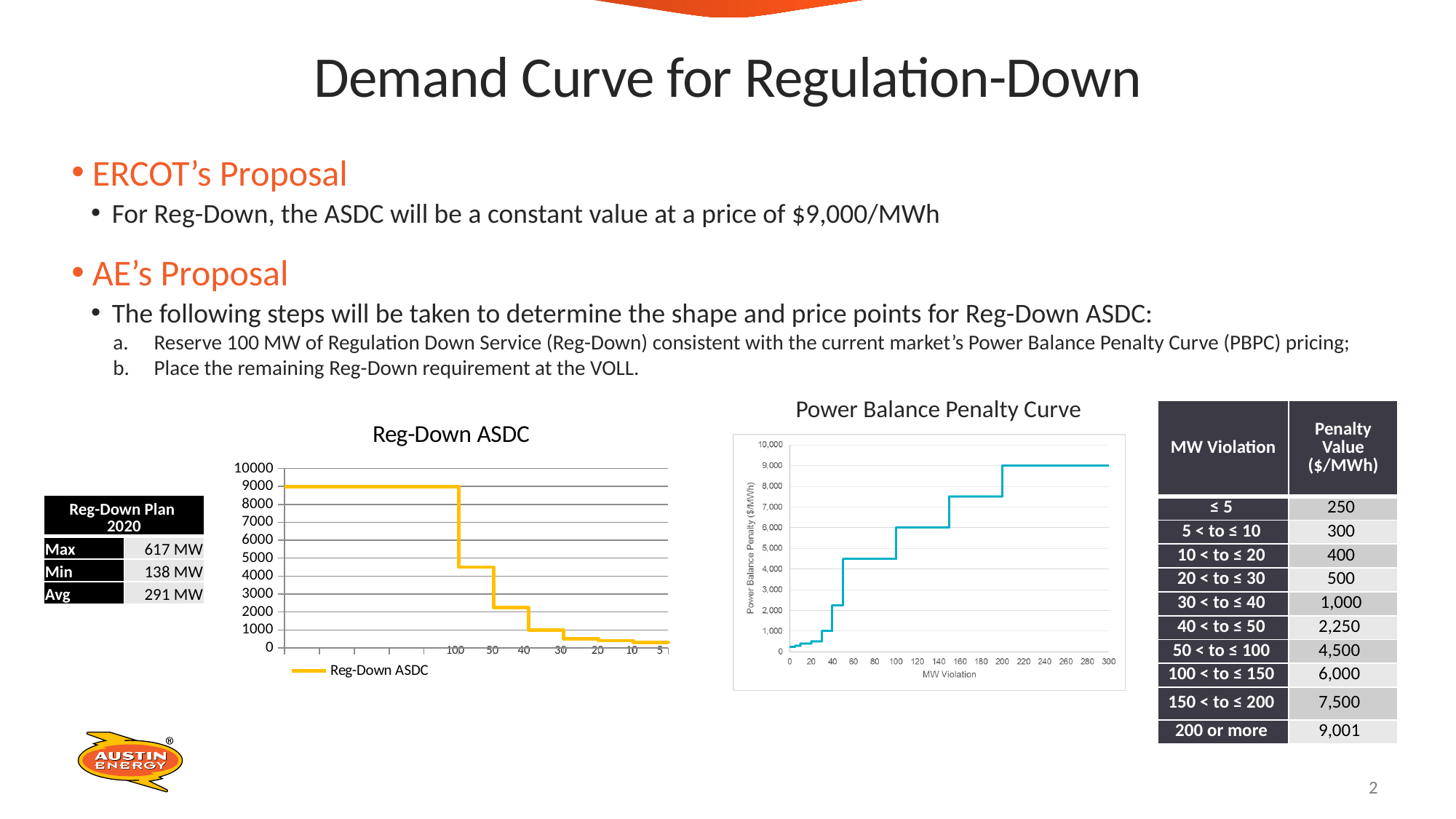
How many series does the legend of the Reg-Down ASDC chart list? 1 In the Power Balance Penalty Curve chart, is the value at an MW Violation of 175 greater or less than 7,000? greater What kind of chart is the Power Balance Penalty Curve chart? line chart In the Reg-Down ASDC chart, do the values rise or fall moving from left to right along the x axis? fall What is the title of the y axis of the Power Balance Penalty Curve chart? Power Balance Penalty ($/MWh) In the Power Balance Penalty Curve chart, is the value at an MW Violation of 75 greater or less than 5,000? less In the Power Balance Penalty Curve chart, which is larger: the value at an MW Violation of 250 or the value at an MW Violation of 120? 250 In the Reg-Down ASDC chart, is the value of the flat portion at the far left greater or less than 8000? greater In the Power Balance Penalty Curve chart, do the values rise or fall as MW Violation increases? rise What kind of chart is the Reg-Down ASDC chart? line chart